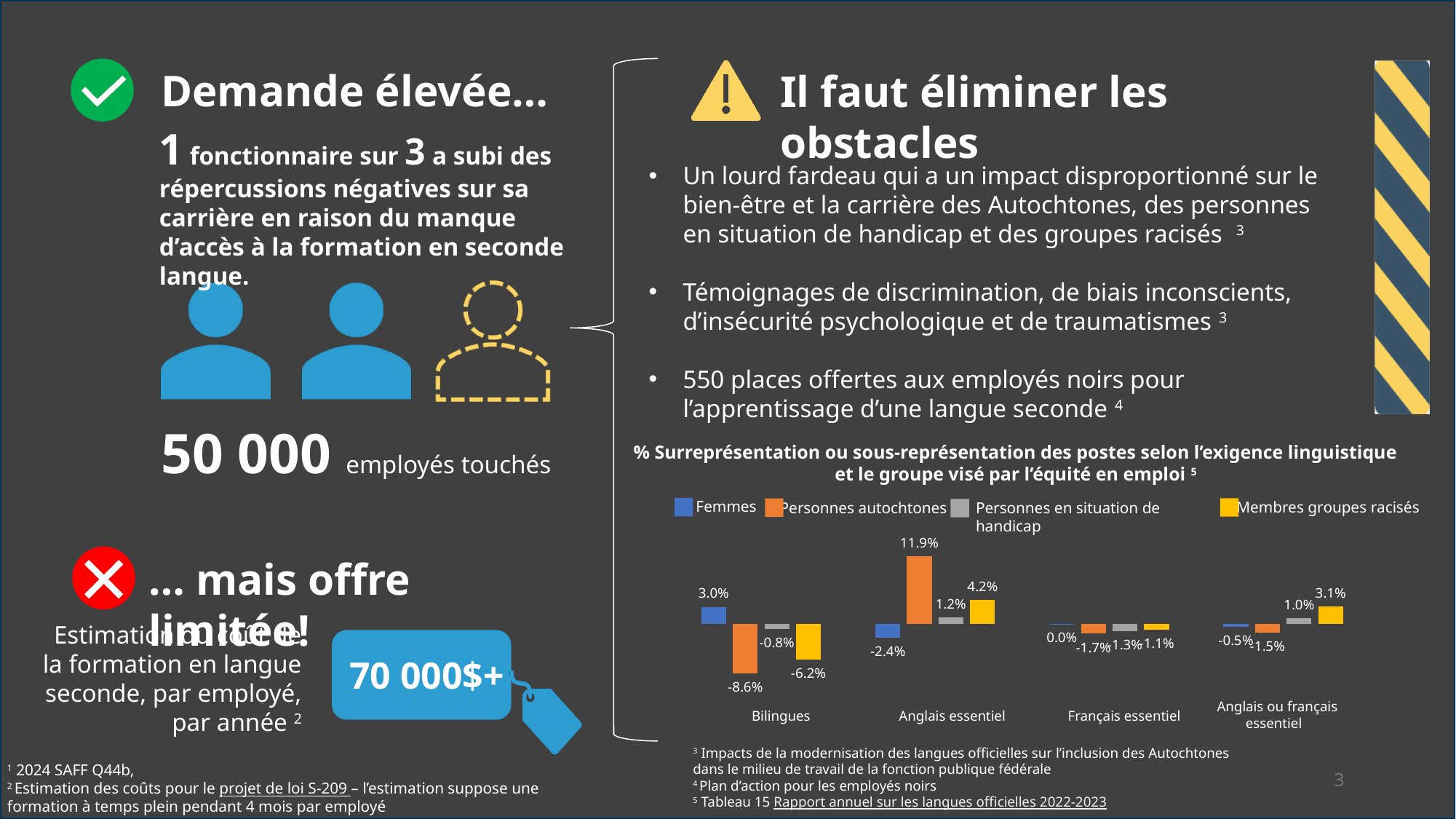
What kind of chart is shown on the slide? Bar chart What is the difference between the Personnes autochtones values for Anglais essentiel and Bilingues? 20.5 percentage points Which series has the highest value in the Anglais essentiel category? Personnes autochtones Which series has the lowest value in the Bilingues category? Personnes autochtones What is the value for Membres groupes racisés in the Bilingues category? -6.2% Which is larger: the Membres groupes racisés value for Anglais essentiel or for Anglais ou français essentiel? Anglais essentiel What colour represents Membres groupes racisés in the chart? Yellow What is the value for Personnes en situation de handicap in the Anglais ou français essentiel category? 1.0% How many language-requirement categories are shown on the x axis? 4 How many series does the legend list? 4 What is the value for Personnes autochtones in the Anglais essentiel category? 11.9% What is the value for Femmes in the Bilingues category? 3.0%